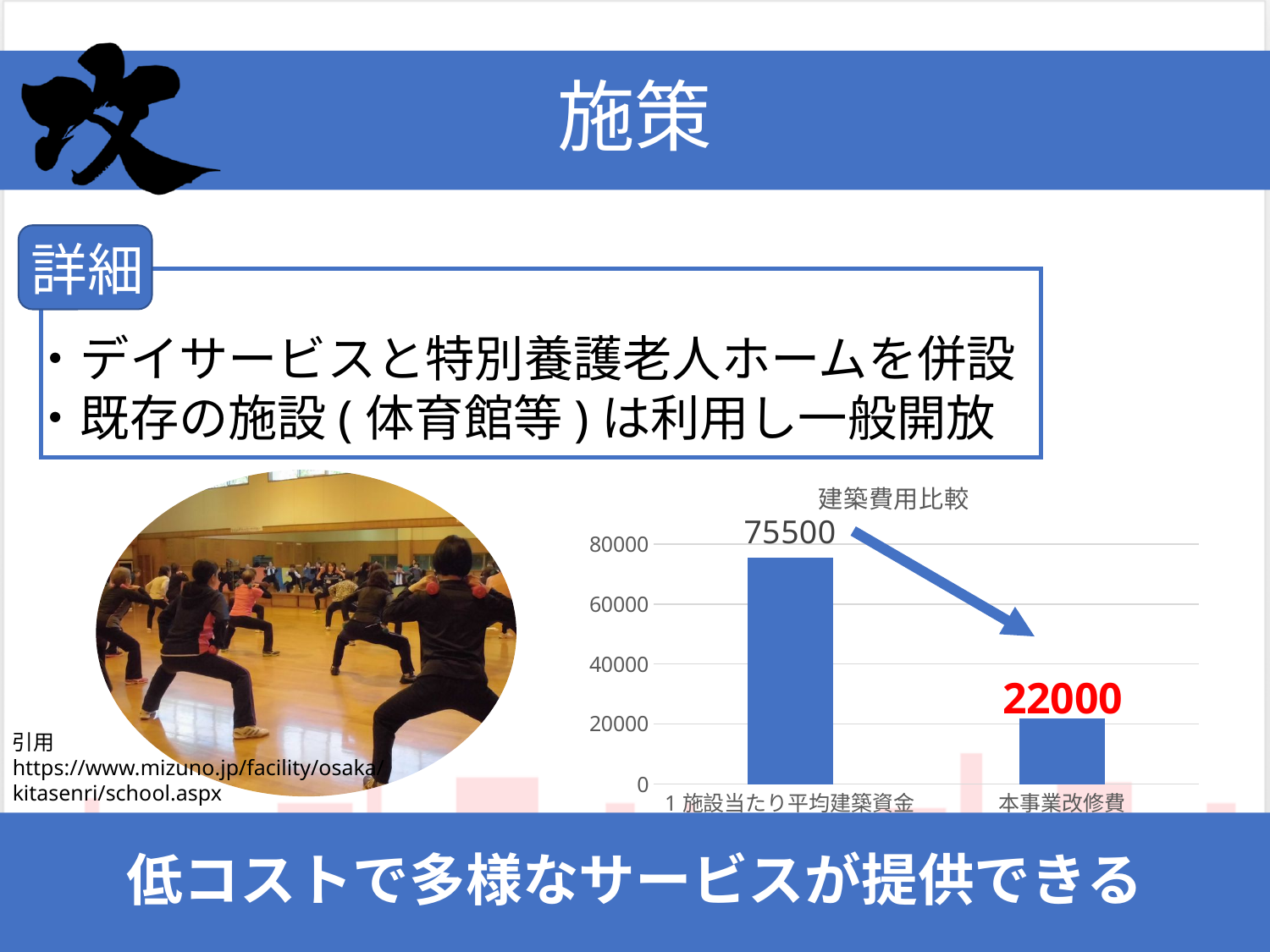
What is the value for １施設当たり平均建築資金 in the 建築費用比較 chart? 75500 What is the difference between １施設当たり平均建築資金 and 本事業改修費 in the 建築費用比較 chart? 53500 How many categories are shown in the 建築費用比較 chart? 2 Which is larger in the 建築費用比較 chart: １施設当たり平均建築資金 or 本事業改修費? １施設当たり平均建築資金 Which category has the lowest value in the 建築費用比較 chart? 本事業改修費 Is the value for 本事業改修費 greater or less than 40000 in the 建築費用比較 chart? less What is the highest value shown on the vertical axis of the 建築費用比較 chart? 80000 Which category has the highest value in the 建築費用比較 chart? １施設当たり平均建築資金 Is the value for １施設当たり平均建築資金 greater or less than 60000 in the 建築費用比較 chart? greater What is the value for 本事業改修費 in the 建築費用比較 chart? 22000 What kind of chart is the 建築費用比較 chart? bar chart What is the title of the chart on the slide? 建築費用比較